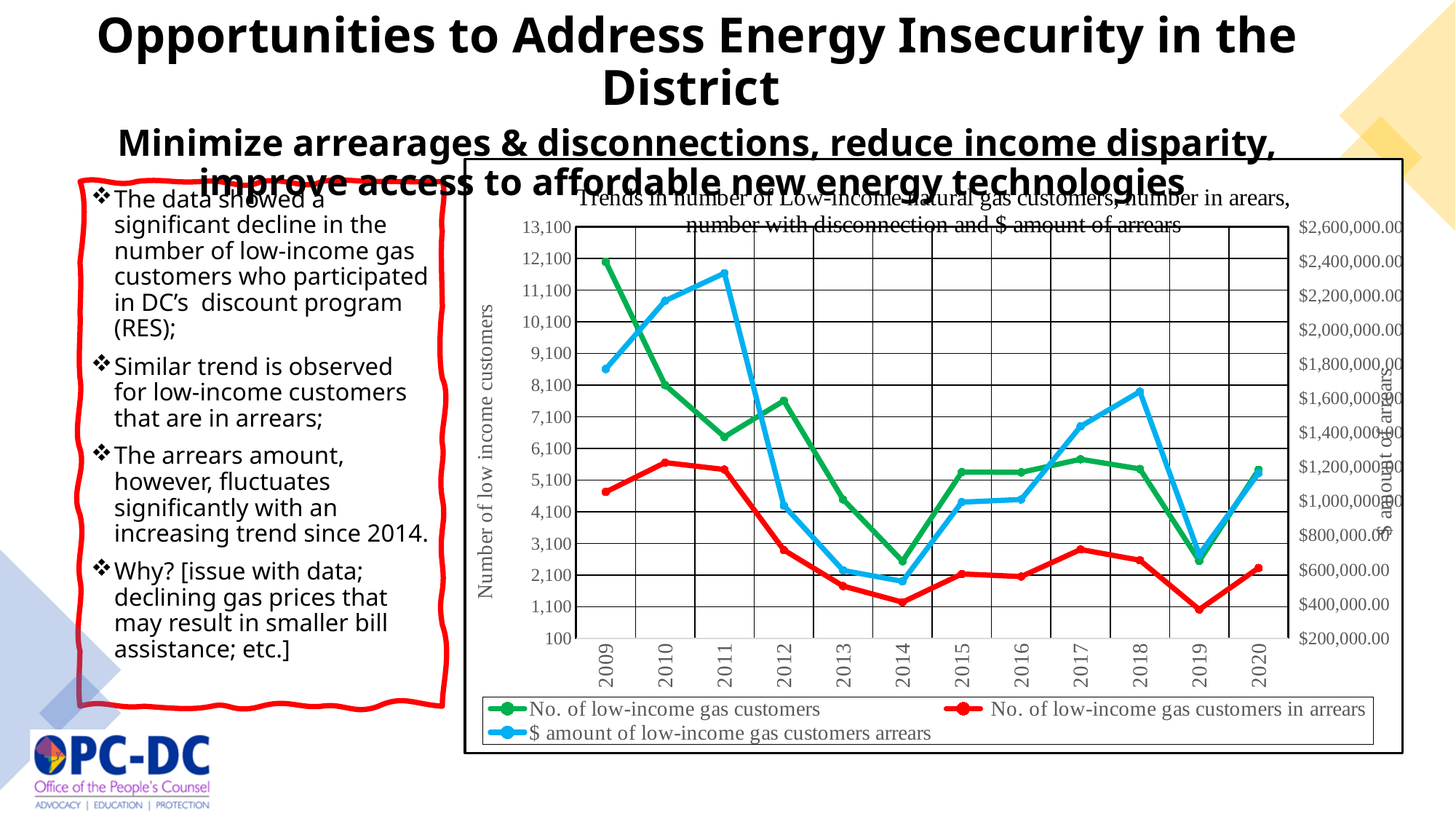
In which year is the $ amount of low-income gas customers arrears (blue line) lowest? 2014 In which year is the number of low-income gas customers in arrears (red line) lowest? 2019 Is the number of low-income gas customers in 2009 greater or less than 11,100? greater In which year is the $ amount of low-income gas customers arrears (blue line) highest? 2011 In which year is the number of low-income gas customers (green line) highest? 2009 Does the number of low-income gas customers (green line) rise or fall from 2009 to 2014? fall What kind of chart is shown on the slide? line chart How many series does the chart's legend list? 3 How many years are plotted along the x axis of the chart? 12 Is the $ amount of low-income gas customers arrears in 2011 greater or less than $2,200,000.00? greater Which year has a larger number of low-income gas customers, 2009 or 2020? 2009 Is the number of low-income gas customers in 2014 greater or less than 3,100? less